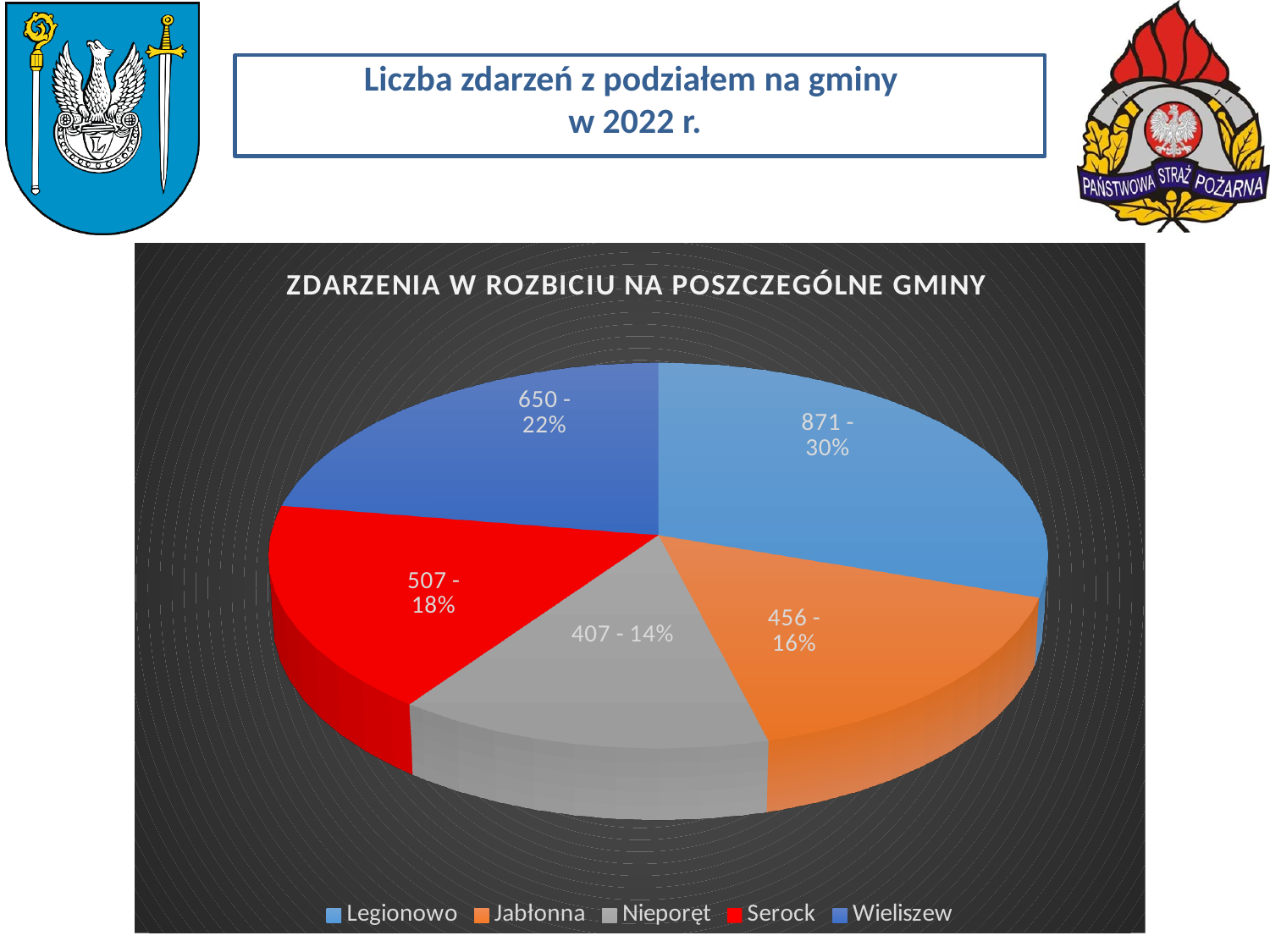
Which gmina has the lowest number of incidents? Nieporęt Which has more incidents, Serock or Jabłonna? Serock What percentage share of the pie does Serock have? 18% What kind of chart is shown on the slide? pie chart What is the difference between the number of incidents for Legionowo and Wieliszew? 221 What is the title of the chart? ZDARZENIA W ROZBICIU NA POSZCZEGÓLNE GMINY What is the number of incidents for Nieporęt? 407 How many gminas (slices) are shown in the pie chart? 5 Which gmina has the highest number of incidents? Legionowo What percentage share of the pie does Jabłonna have? 16% What is the number of incidents for Wieliszew? 650 What is the number of incidents for Legionowo? 871